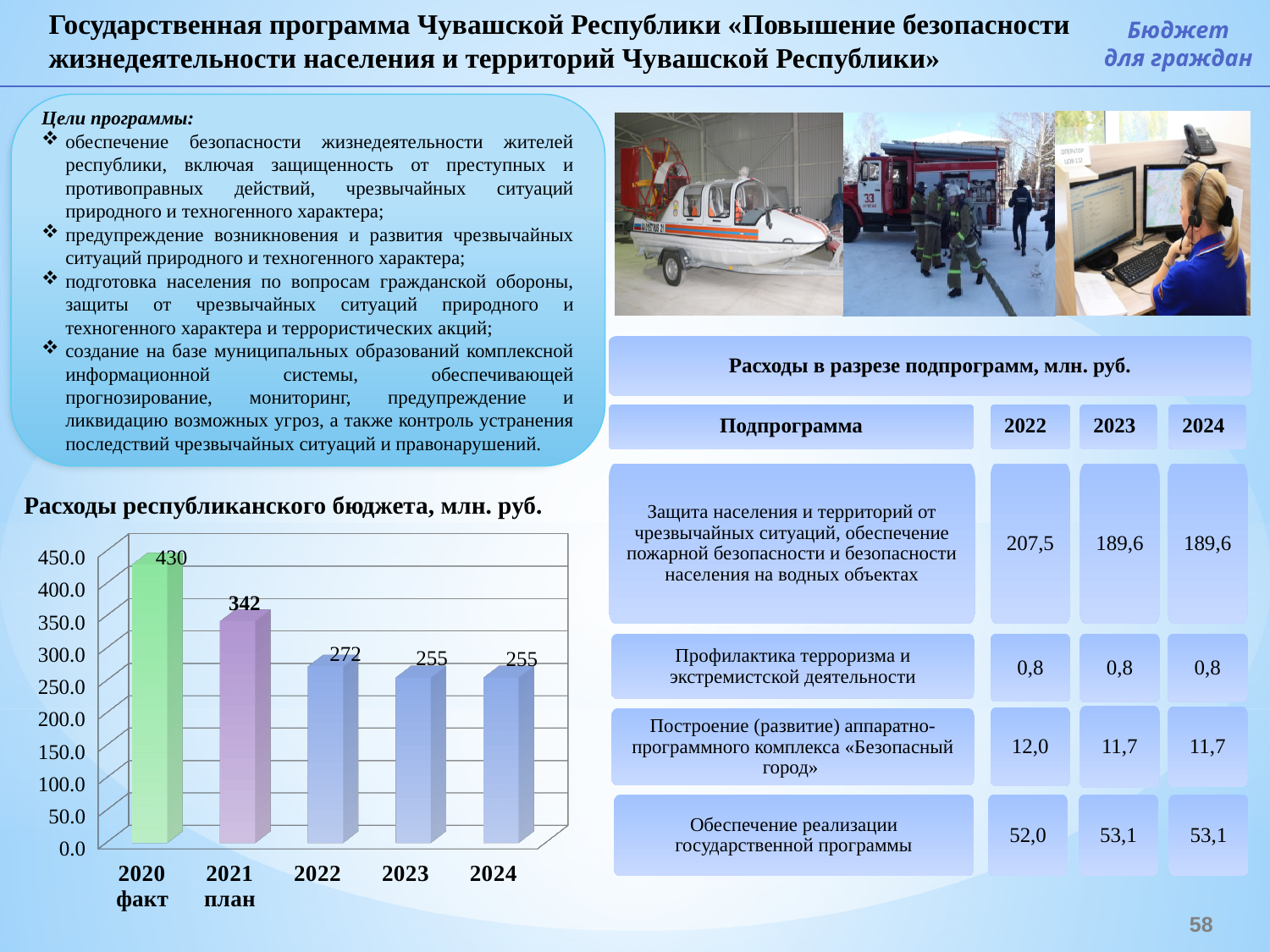
Which is larger in the chart 'Расходы республиканского бюджета, млн. руб.': the value for 2021 план or the value for 2022? 2021 план What is the value for 2024 in the chart 'Расходы республиканского бюджета, млн. руб.'? 255 What kind of chart is 'Расходы республиканского бюджета, млн. руб.'? bar chart Which category has the highest value in the chart 'Расходы республиканского бюджета, млн. руб.'? 2020 факт Is the value for 2022 in the chart 'Расходы республиканского бюджета, млн. руб.' greater or less than 300.0? less Do the values in the chart 'Расходы республиканского бюджета, млн. руб.' rise or fall from 2020 факт to 2023? fall What is the difference between the values for 2020 факт and 2021 план in the chart 'Расходы республиканского бюджета, млн. руб.'? 88 What is the difference between the values for 2022 and 2023 in the chart 'Расходы республиканского бюджета, млн. руб.'? 17 What is the value for 2021 план in the chart 'Расходы республиканского бюджета, млн. руб.'? 342 What is the value for 2020 факт in the chart 'Расходы республиканского бюджета, млн. руб.'? 430 How many bars are shown in the chart 'Расходы республиканского бюджета, млн. руб.'? 5 What is the value for 2022 in the chart 'Расходы республиканского бюджета, млн. руб.'? 272